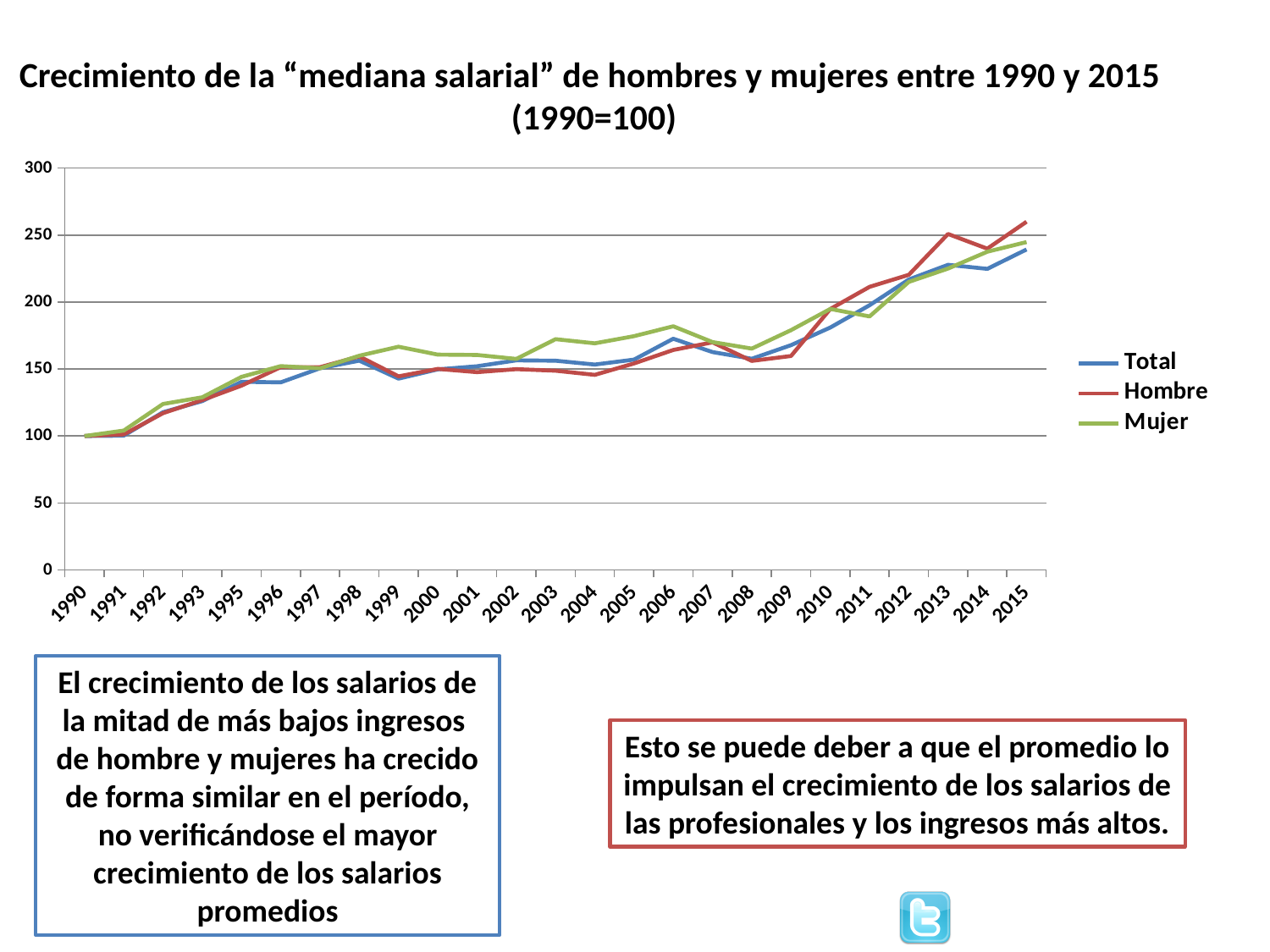
How many years are plotted along the x axis? 25 In 2011, which is larger: the value for Hombre or the value for Mujer? Hombre Do the values generally rise or fall from 1990 to 2015? rise Is the value for Mujer in 2011 greater or less than 200? less Which series has the lowest value in 2015? Total What kind of chart is shown on the slide? line chart Is the value for Total in 1996 greater or less than 150? less What colour is the line for the Mujer series? green Which series has the highest value in 2015? Hombre Is the value for Hombre in 2015 greater or less than 250? greater How many series does the legend list? 3 What is the value of all three series in 1990? 100